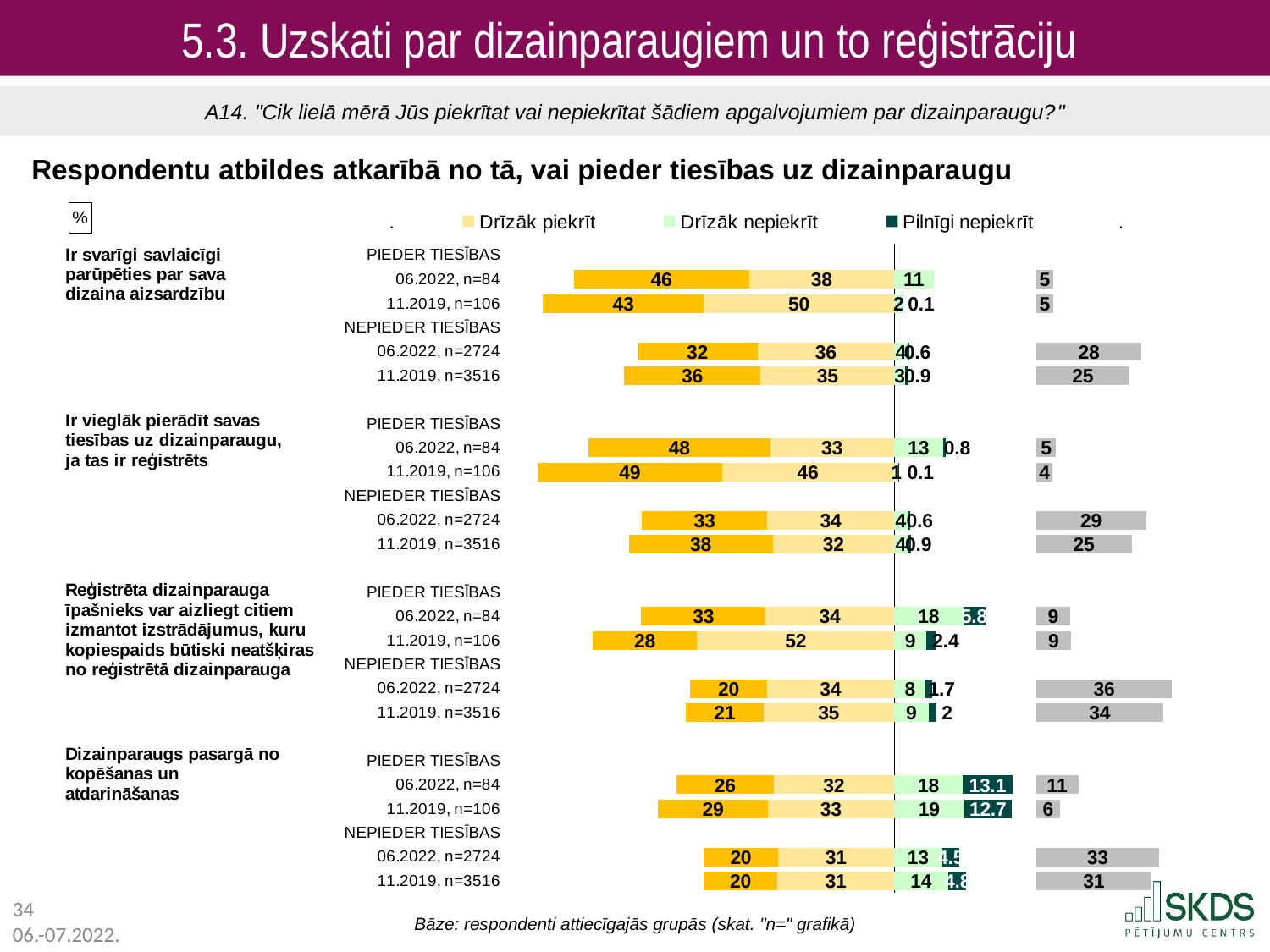
How many statements (row groups) are shown in the chart? 4 Which legend entry is shown with the dark green colour? Pilnīgi nepiekrīt Across all rows in the chart, which row has the lowest 'Drīzāk nepiekrīt' value? Ir vieglāk pierādīt savas tiesības..., PIEDER TIESĪBAS, 11.2019, n=106 (1) For the statement 'Reģistrēta dizainparauga īpašnieks var aizliegt citiem izmantot izstrādājumus...', what is the difference between the 'Drīzāk piekrīt' values for PIEDER TIESĪBAS in 11.2019 (n=106) and 06.2022 (n=84)? 18 For the statement 'Reģistrēta dizainparauga īpašnieks var aizliegt citiem izmantot izstrādājumus...', what is the 'Drīzāk piekrīt' value for PIEDER TIESĪBAS, 11.2019, n=106? 52 For the statement 'Ir vieglāk pierādīt savas tiesības uz dizainparaugu, ja tas ir reģistrēts', what is the 'Pilnīgi nepiekrīt' value for PIEDER TIESĪBAS, 06.2022, n=84? 0.8 What kind of chart is shown on the slide? bar chart For the statement 'Ir svarīgi savlaicīgi parūpēties par sava dizaina aizsardzību', what is the 'Drīzāk piekrīt' value for PIEDER TIESĪBAS, 06.2022, n=84? 38 Across all rows in the chart, which row has the highest 'Drīzāk piekrīt' value? Reģistrēta dizainparauga īpašnieks var aizliegt citiem..., PIEDER TIESĪBAS, 11.2019, n=106 (52) For the statement 'Dizainparaugs pasargā no kopēšanas un atdarināšanas', which PIEDER TIESĪBAS wave has the larger 'Pilnīgi nepiekrīt' value: 06.2022, n=84 or 11.2019, n=106? 06.2022, n=84 For the statement 'Ir svarīgi savlaicīgi parūpēties par sava dizaina aizsardzību', what is the 'Drīzāk nepiekrīt' value for NEPIEDER TIESĪBAS, 11.2019, n=3516? 3 For the statement 'Dizainparaugs pasargā no kopēšanas un atdarināšanas', what is the 'Pilnīgi nepiekrīt' value for NEPIEDER TIESĪBAS, 06.2022, n=2724? 4.5